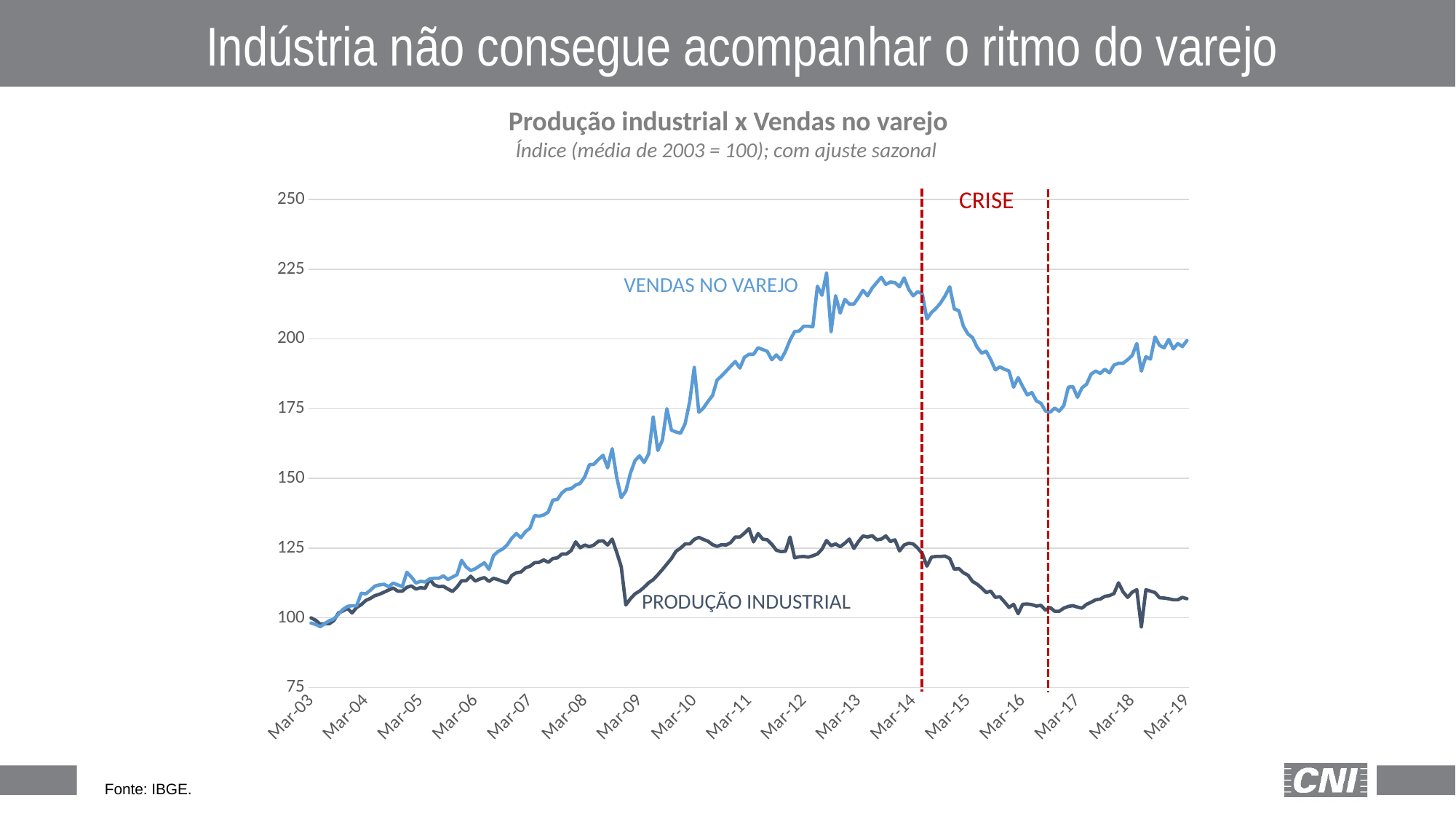
What is the title of the chart? Produção industrial x Vendas no varejo What kind of chart is shown on the slide? Line chart How many year labels are shown on the x axis? 17 How many series are plotted on the chart? 2 Is the value for PRODUÇÃO INDUSTRIAL at Mar-19 greater or less than 100? greater Does the VENDAS NO VAREJO series generally rise or fall between Mar-03 and Mar-13? rise Does the PRODUÇÃO INDUSTRIAL series generally rise or fall between Mar-14 and Mar-17? fall What label is written in red between the two dashed vertical lines? CRISE Is the value for VENDAS NO VAREJO at Mar-13 greater or less than 200? greater Which series has the higher value at Mar-13, VENDAS NO VAREJO or PRODUÇÃO INDUSTRIAL? VENDAS NO VAREJO Is the value for VENDAS NO VAREJO at Mar-09 greater or less than 125? greater